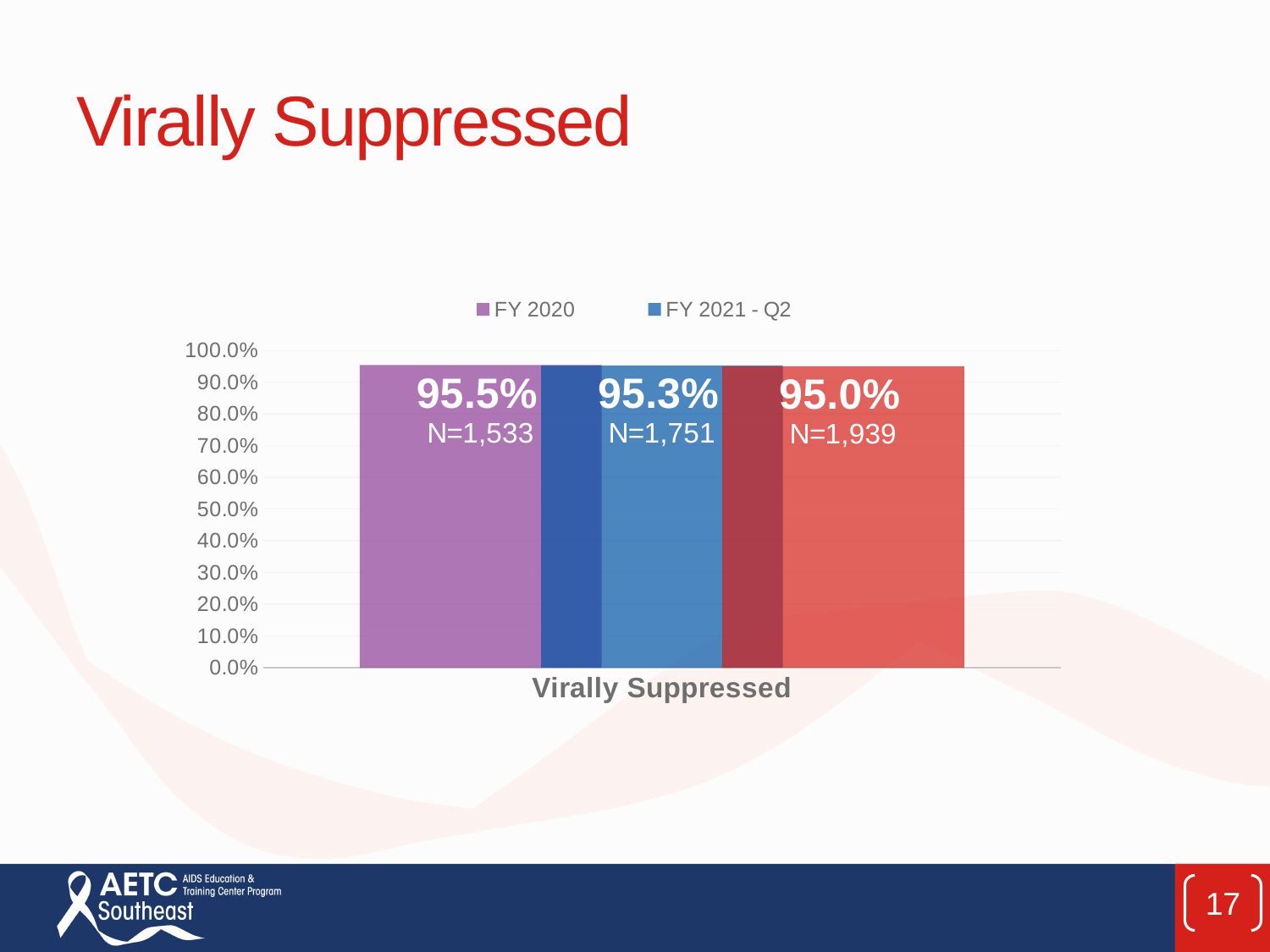
Do the percentages rise or fall from left to right across the bars? fall What is the lowest percentage shown on the chart? 95.0% What is the virally suppressed percentage for FY 2021 - Q2? 95.3% What is the N value shown on the red bar on the right? N=1,939 Which series has the highest virally suppressed percentage? FY 2020 How many series does the legend list? 2 What is the virally suppressed percentage for FY 2020? 95.5% What is the difference between the FY 2020 and FY 2021 - Q2 percentages? 0.2% What percentage is shown on the red bar on the right? 95.0% What is the N value shown on the FY 2021 - Q2 bar? N=1,751 What is the N value shown on the FY 2020 bar? N=1,533 Which is larger, the FY 2020 percentage or the FY 2021 - Q2 percentage? FY 2020